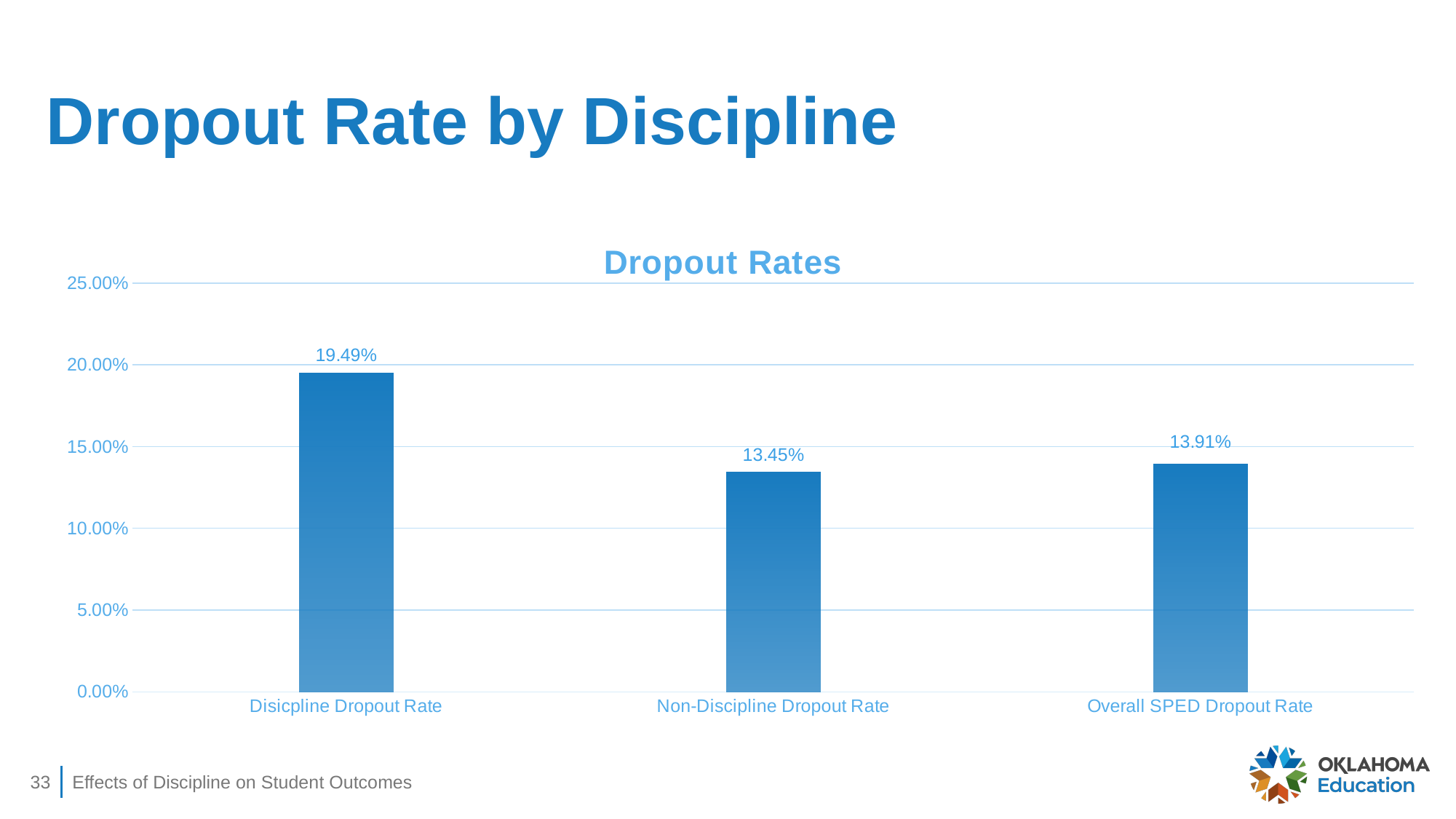
What is the difference between the Disicpline Dropout Rate and the Non-Discipline Dropout Rate? 6.04% What kind of chart is shown on the slide? bar chart What is the difference between the Overall SPED Dropout Rate and the Non-Discipline Dropout Rate? 0.46% Which is larger, the Disicpline Dropout Rate or the Overall SPED Dropout Rate? Disicpline Dropout Rate How many categories are shown in the chart? 3 What is the value for Non-Discipline Dropout Rate? 13.45% Is the value for Non-Discipline Dropout Rate greater or less than 15.00%? less Which category has the lowest dropout rate? Non-Discipline Dropout Rate Which category has the highest dropout rate? Disicpline Dropout Rate What is the title of the chart? Dropout Rates What is the value for Overall SPED Dropout Rate? 13.91% What is the value for Disicpline Dropout Rate? 19.49%